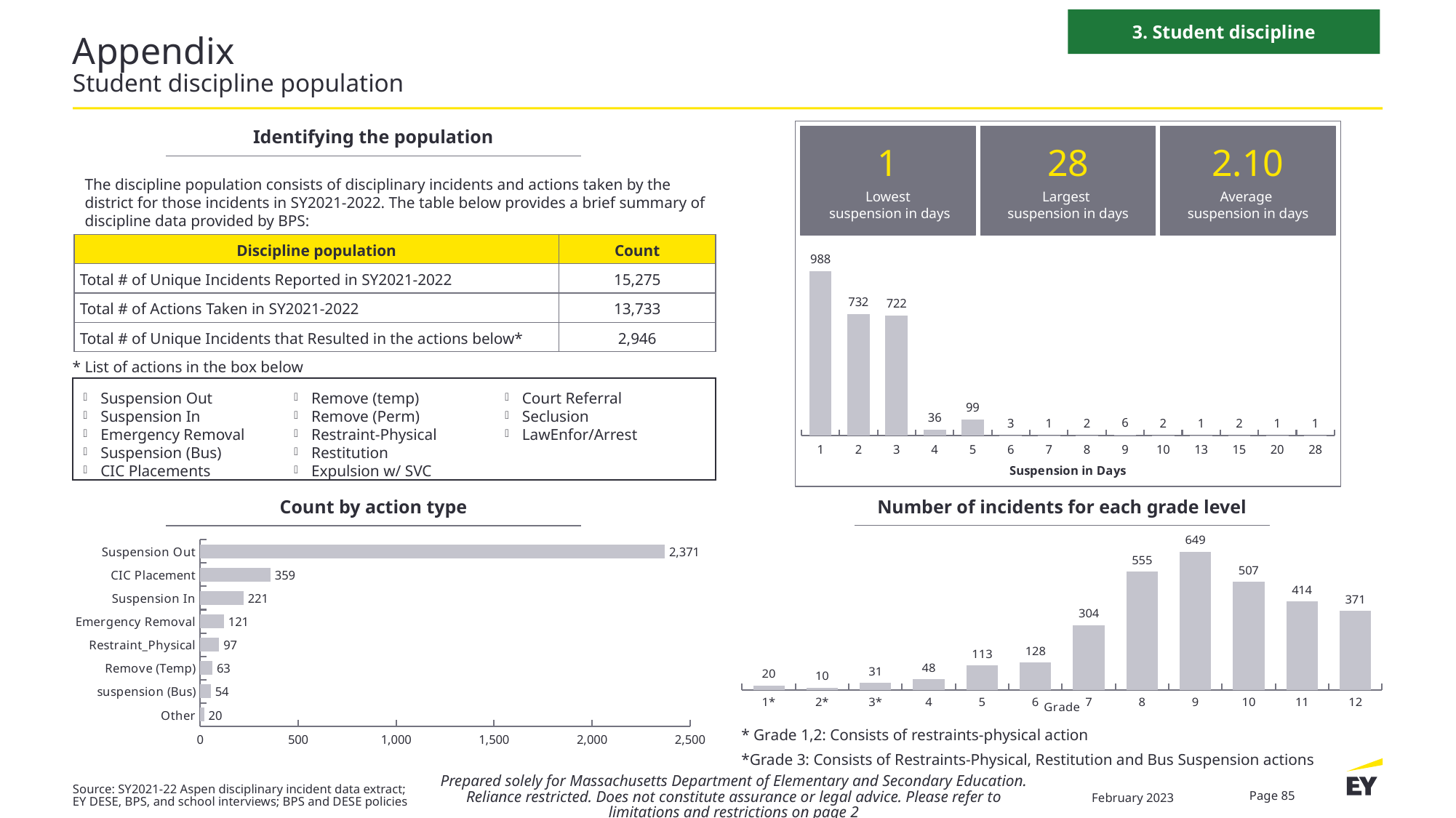
In the 'Suspension in Days' chart, what is the value for 1 day? 988 In the 'Number of incidents for each grade level' chart, which is larger, the value for grade 10 or grade 11? Grade 10 In the 'Suspension in Days' chart, what is the difference between the values for 2 days and 3 days? 10 In the 'Suspension in Days' chart, how many suspension-day categories are shown on the x axis? 14 In the 'Suspension in Days' chart, what is the value for 5 days? 99 In the 'Count by action type' chart, what is the value for CIC Placement? 359 In the 'Count by action type' chart, which action type has the highest count? Suspension Out In the 'Number of incidents for each grade level' chart, which grade has the highest number of incidents? 9 In the 'Count by action type' chart, which action type has the lowest count? Other In the 'Number of incidents for each grade level' chart, what is the value for grade 7? 304 What kind of chart is 'Count by action type'? Bar chart In the 'Count by action type' chart, what is the difference between Suspension In and Emergency Removal? 100